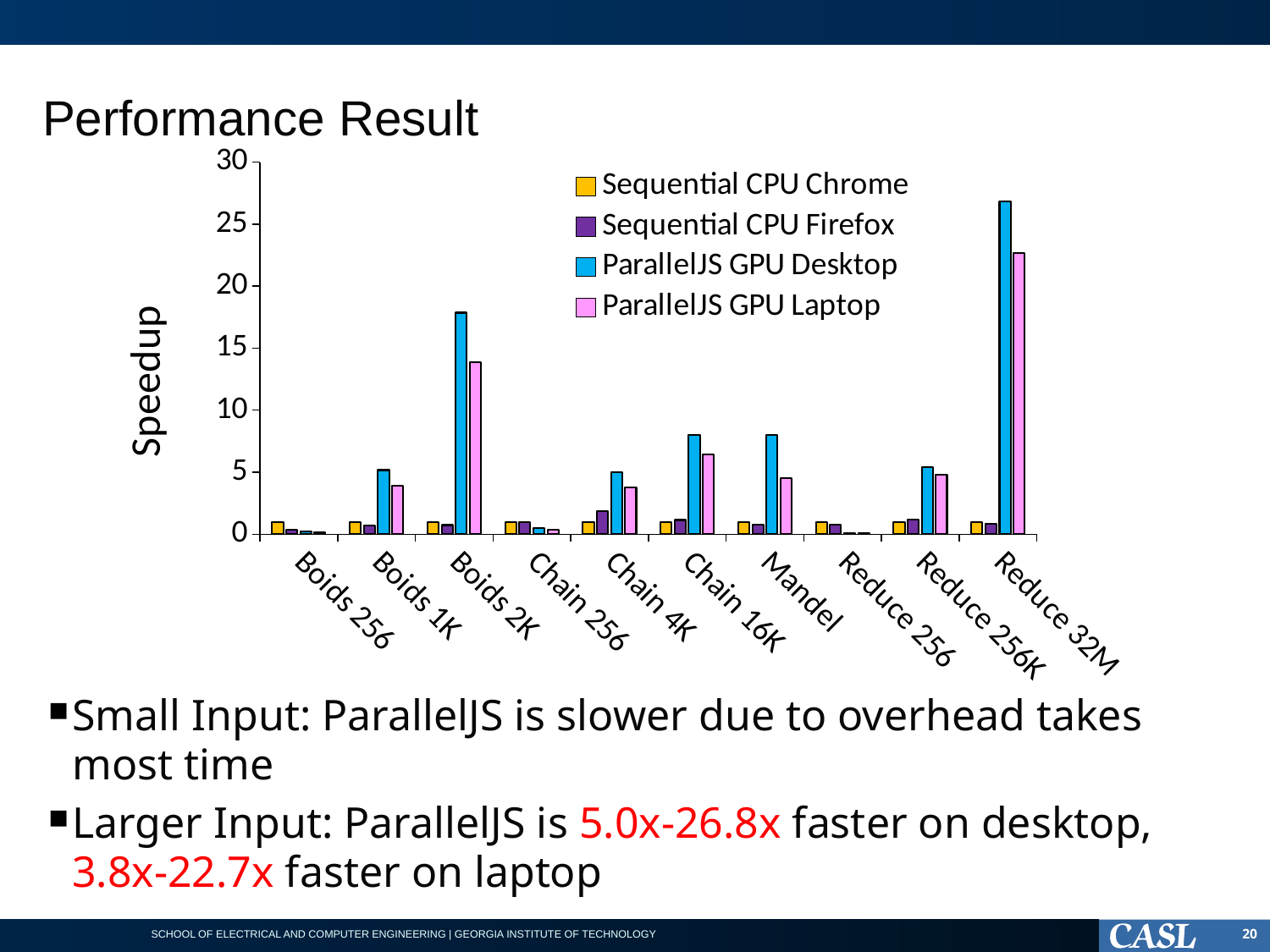
What is the label of the y axis? Speedup Is the ParallelJS GPU Laptop value for Reduce 32M greater or less than 25? less How many categories are shown on the x axis? 10 How many series does the legend list? 4 What kind of chart is shown on the slide? bar chart Is the ParallelJS GPU Desktop value for Reduce 32M greater or less than 25? greater Which category has the highest ParallelJS GPU Laptop speedup? Reduce 32M Which series is shown in yellow in the legend? Sequential CPU Chrome Which category has the highest ParallelJS GPU Desktop speedup? Reduce 32M For Chain 16K, which is larger: the ParallelJS GPU Desktop value or the ParallelJS GPU Laptop value? ParallelJS GPU Desktop Is the ParallelJS GPU Desktop value for Boids 2K greater or less than 15? greater